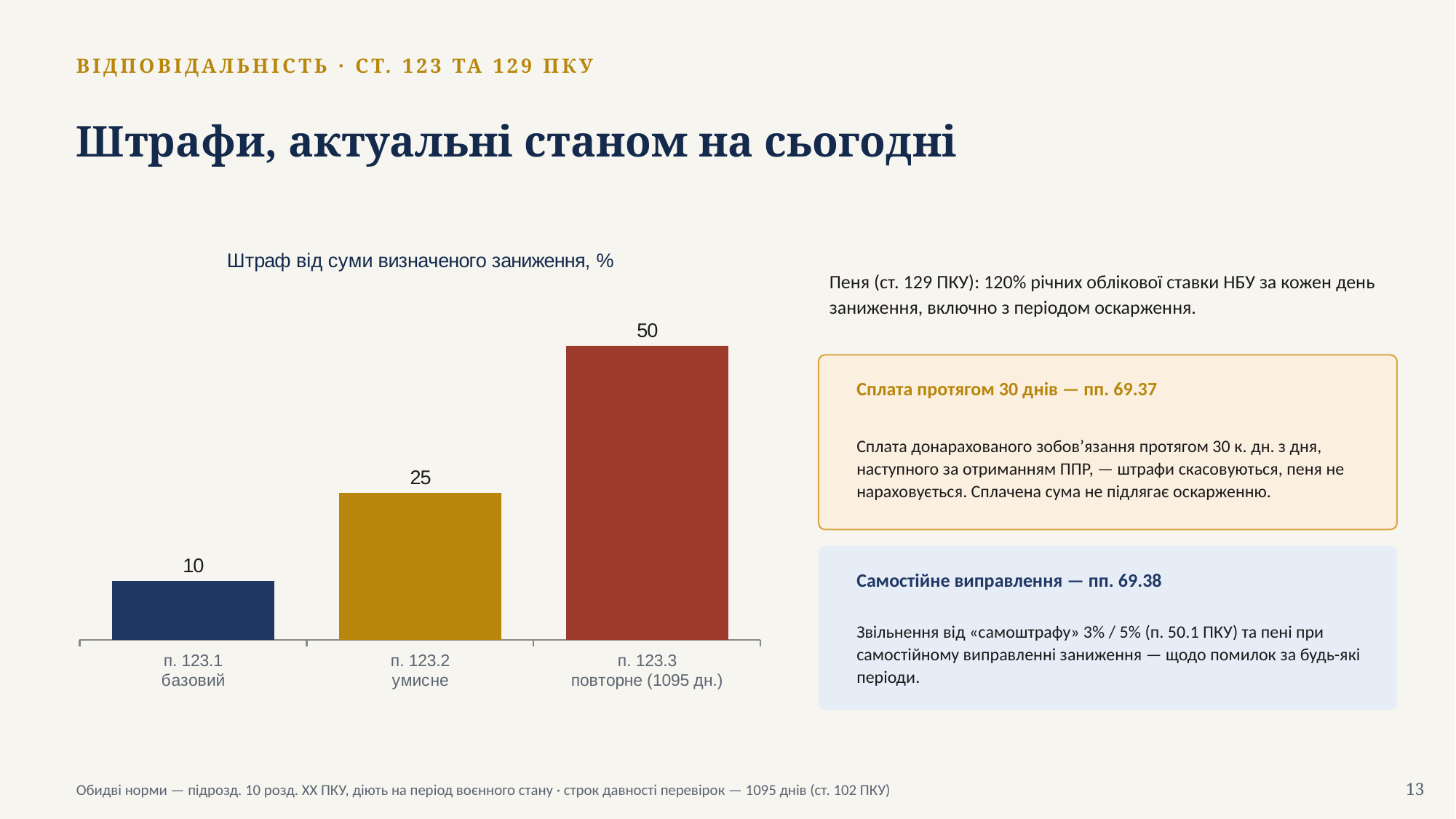
What is the value for п. 123.3 повторне (1095 дн.)? 50 Which is larger, the value for п. 123.1 базовий or п. 123.2 умисне? п. 123.2 умисне What is the value for п. 123.2 умисне? 25 What is the title of the chart? Штраф від суми визначеного заниження, % What is the difference between the values for п. 123.3 повторне (1095 дн.) and п. 123.2 умисне? 25 What is the difference between the values for п. 123.2 умисне and п. 123.1 базовий? 15 What kind of chart is shown on the slide? bar chart How many categories are shown in the chart? 3 Do the values rise or fall from left to right along the x axis? rise What is the value for п. 123.1 базовий? 10 Which category has the lowest value? п. 123.1 базовий Which category has the highest value? п. 123.3 повторне (1095 дн.)